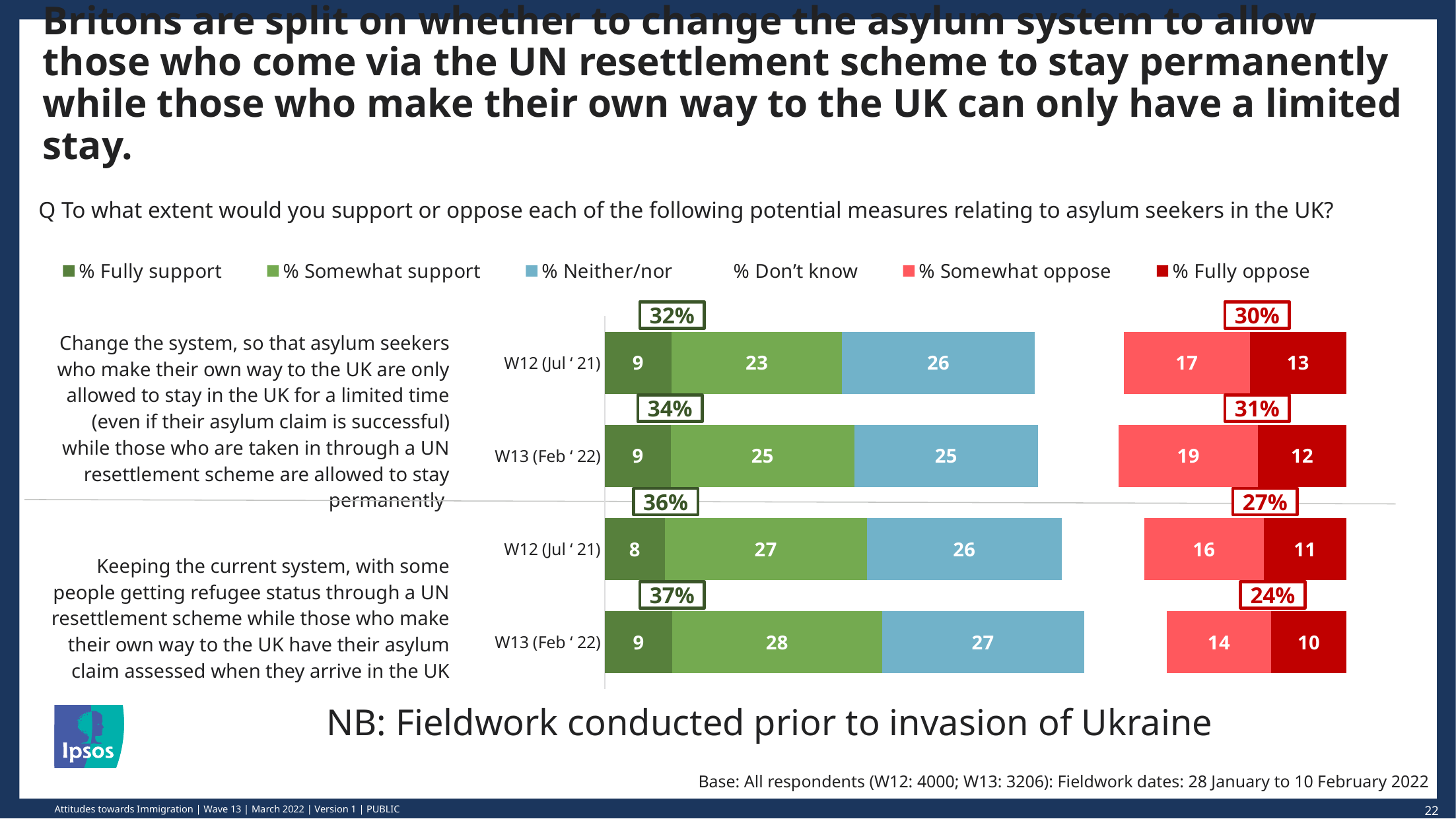
What is the % Fully oppose value for 'Keeping the current system' in W12 (Jul '21)? 11 Which bar has the highest boxed net support percentage? Keeping the current system, W13 (Feb '22) How many bars are plotted in the chart? 4 How many series does the chart legend list? 6 What is the % Somewhat support value for 'Change the system' in W13 (Feb '22)? 25 By how much did % Somewhat oppose for 'Change the system' change from W12 (Jul '21) to W13 (Feb '22)? 2 What is the boxed net support figure for 'Keeping the current system' in W13 (Feb '22)? 37% Which bar has the lowest boxed net oppose percentage? Keeping the current system, W13 (Feb '22) Which is larger: % Neither/nor for 'Change the system' in W12 (Jul '21) or % Neither/nor for 'Keeping the current system' in W13 (Feb '22)? Keeping the current system, W13 (Feb '22) Did the net support for 'Keeping the current system' rise or fall from W12 (Jul '21) to W13 (Feb '22)? Rise What is the total of % Fully support and % Somewhat support for 'Change the system' in W12 (Jul '21)? 32 What kind of chart is shown on the slide? Stacked bar chart